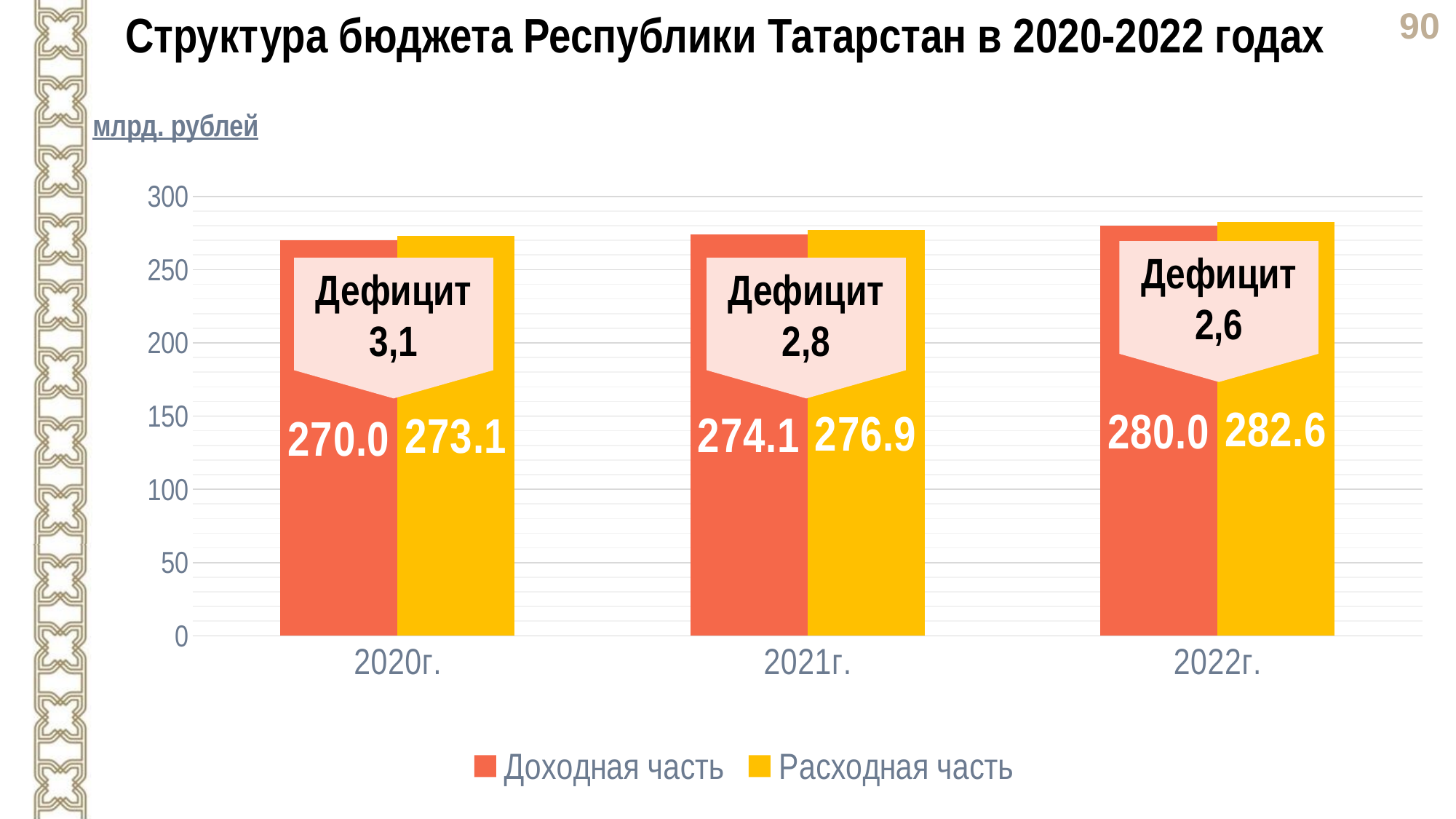
What is the difference between Доходная часть in 2022г. and Доходная часть in 2020г.? 10.0 Which is larger in 2020г., Доходная часть or Расходная часть? Расходная часть How many series does the legend list? 2 Which year has the highest Доходная часть value? 2022г. What is the value of Расходная часть for 2022г.? 282.6 What is the difference between Расходная часть and Доходная часть in 2021г.? 2.8 What is the value of Расходная часть for 2021г.? 276.9 Do the Доходная часть values rise or fall from 2020г. to 2022г.? Rise Which year has the lowest Расходная часть value? 2020г. What kind of chart is shown on the slide? Bar chart What is the value of Доходная часть for 2020г.? 270.0 How many years are shown on the x axis? 3